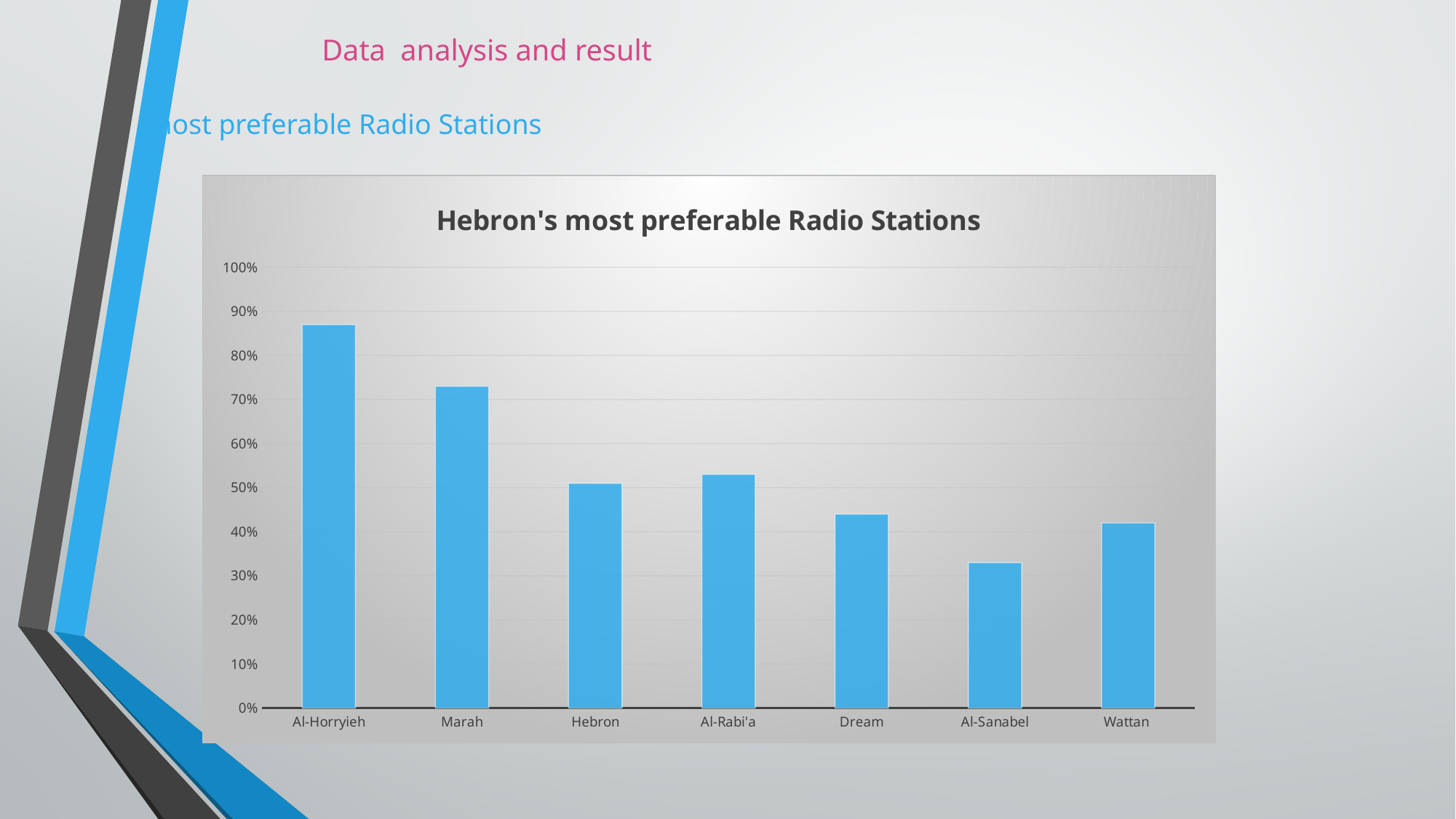
Is the value for Al-Horryieh greater or less than 80%? greater Which radio station has the highest bar in the chart? Al-Horryieh What is the title of the chart? Hebron's most preferable Radio Stations Is the value for Dream greater or less than 50%? less Is the value for Hebron greater or less than 60%? less What type of chart is shown on the slide? bar chart Which radio station has the lowest bar in the chart? Al-Sanabel Which has a larger value, Wattan or Al-Sanabel? Wattan How many radio stations are shown on the x axis of the chart? 7 Which has a larger value, Marah or Al-Rabi'a? Marah